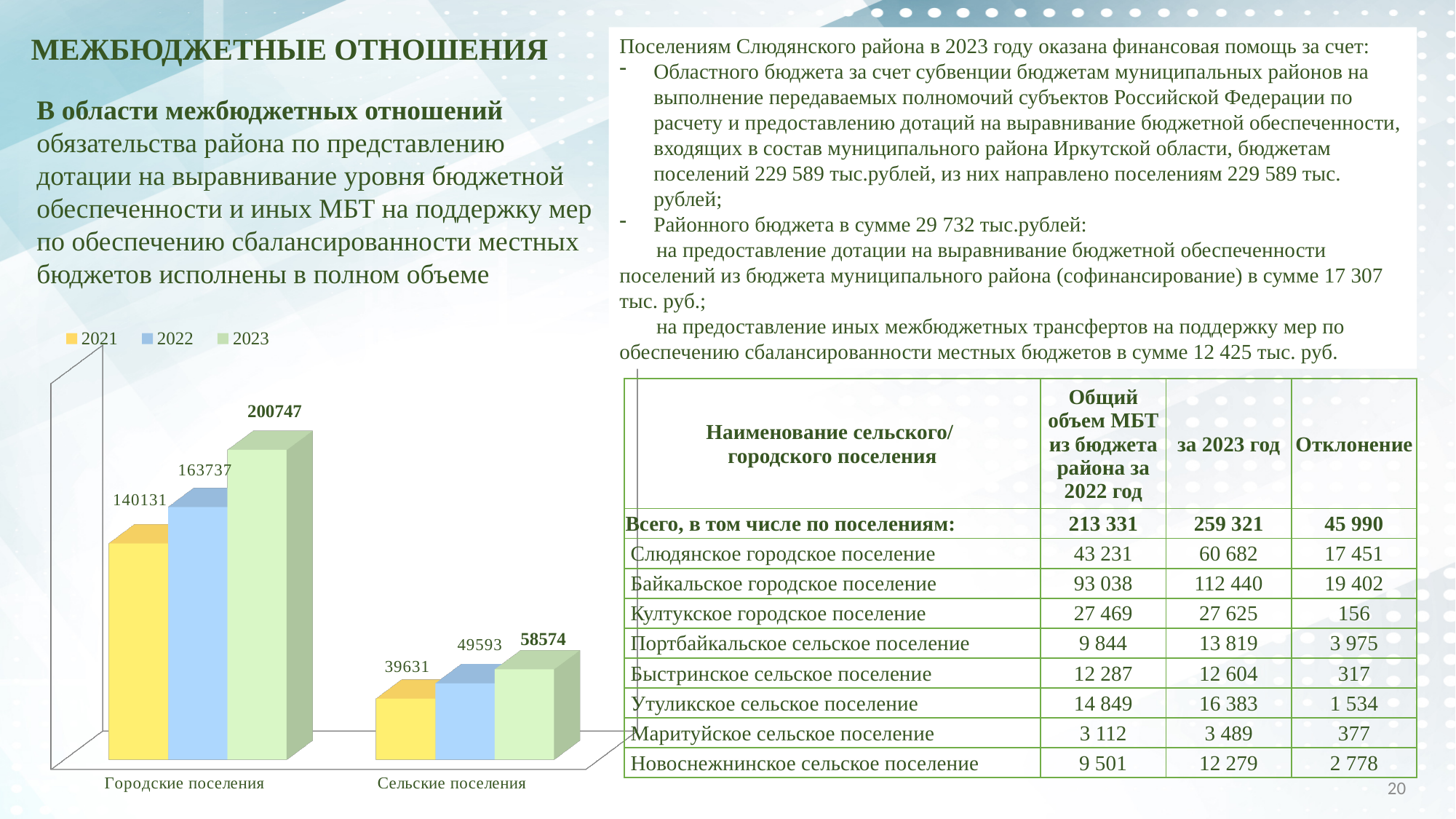
How many series does the chart legend list? 3 What is the value for Городские поселения in 2022? 163737 What is the value for Сельские поселения in 2023? 58574 What is the difference between the 2023 and 2022 values for Городские поселения? 37010 Which year has the lowest value for Сельские поселения? 2021 How many categories are shown on the x axis of the chart? 2 Which is larger: the 2021 value for Городские поселения or the 2023 value for Сельские поселения? 2021 value for Городские поселения What is the difference between the 2022 and 2021 values for Сельские поселения? 9962 What is the value for Городские поселения in 2023? 200747 Which year has the highest value for Городские поселения? 2023 What kind of chart is shown on the slide? Bar chart What is the value for Сельские поселения in 2021? 39631